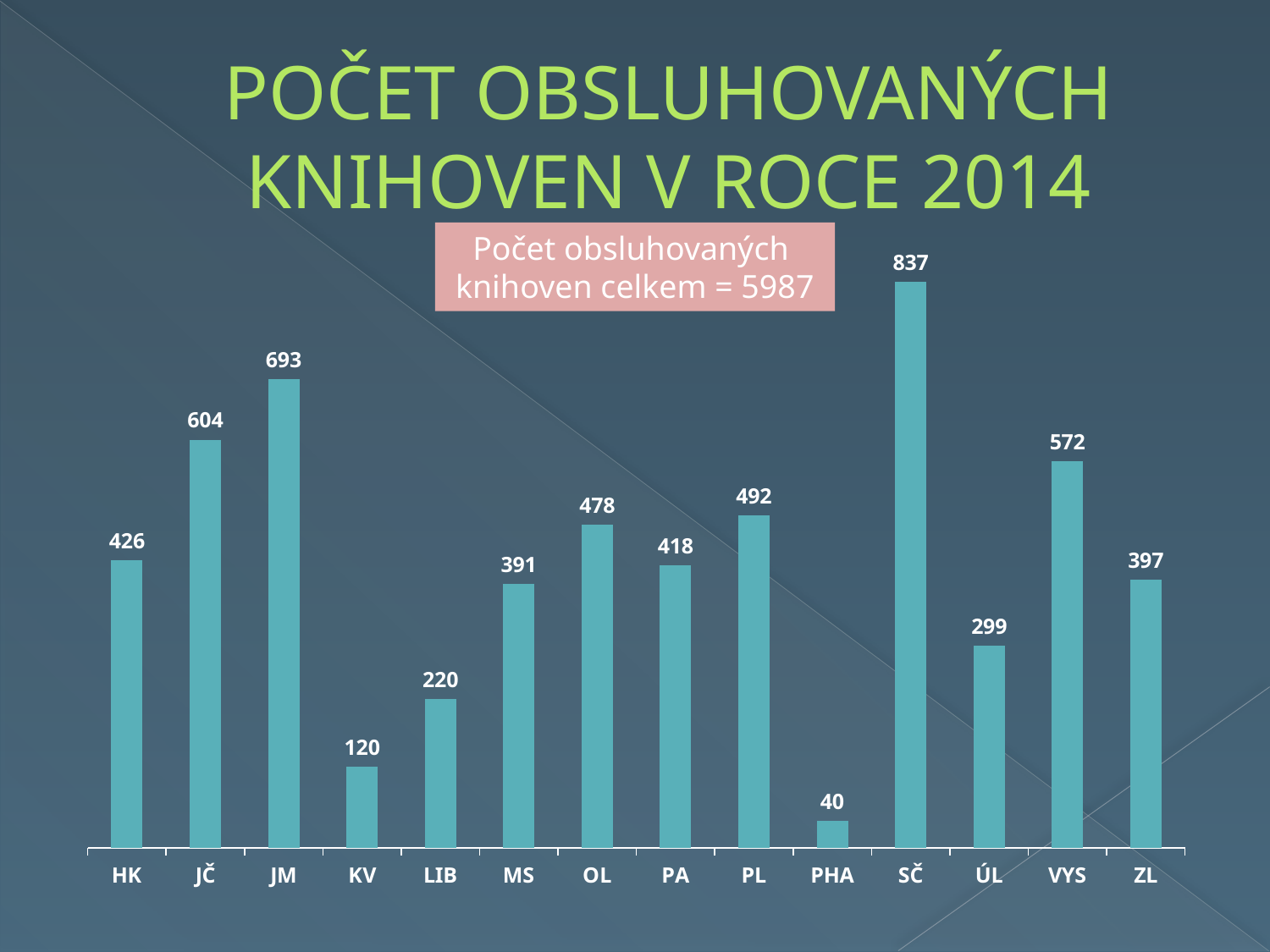
Which category has the highest value? SČ What is the value for SČ? 837 How many categories are shown on the x axis? 14 Which category has the lowest value? PHA What is the difference between the values for SČ and PHA? 797 Which is larger, the value for OL or the value for PL? PL What kind of chart is shown on the slide? bar chart Which is larger, the value for HK or the value for ZL? HK What is the value for VYS? 572 What total number of served libraries is stated in the box on the slide? 5987 What is the value for KV? 120 What is the difference between the values for JM and JČ? 89